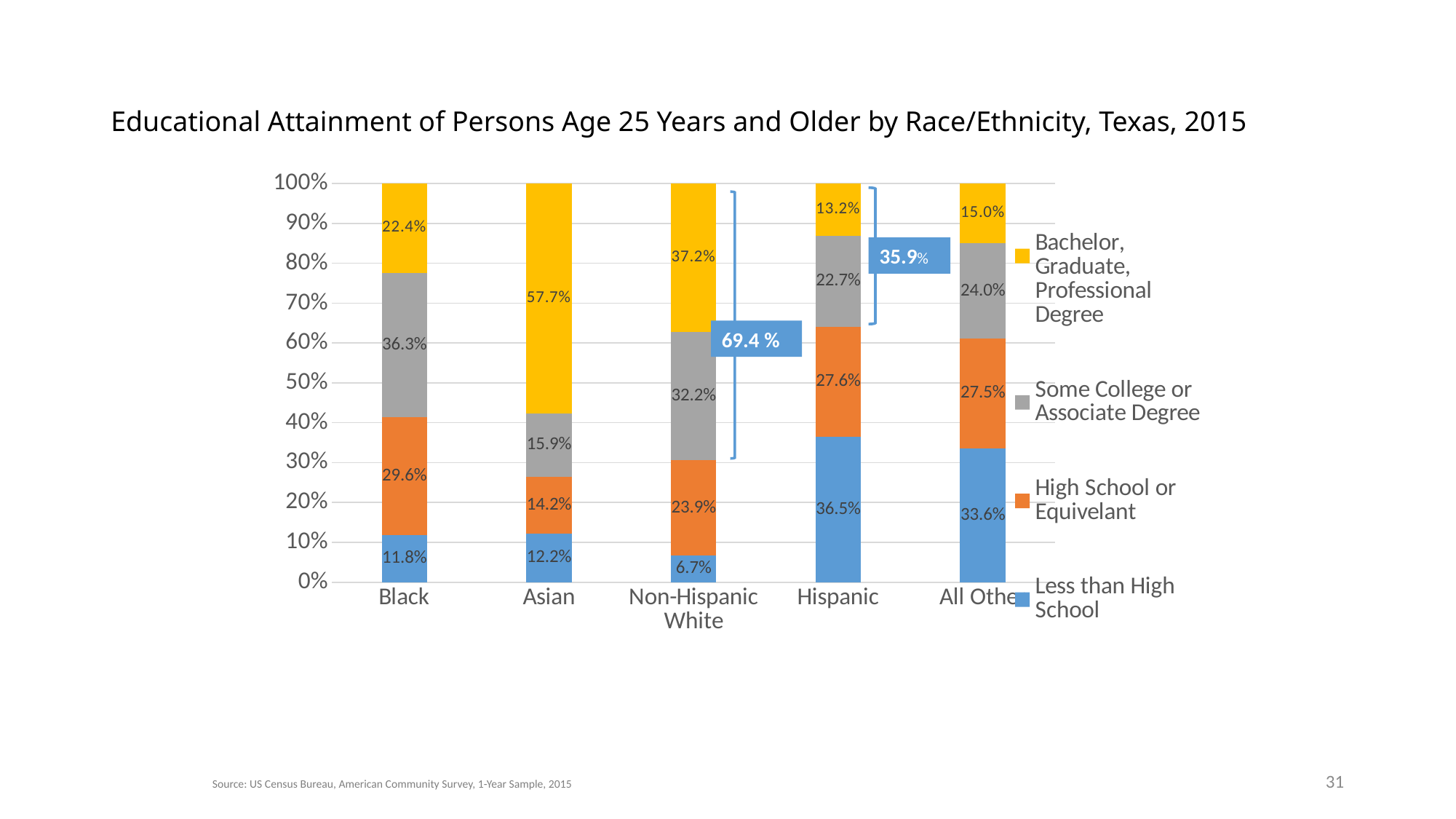
Which race/ethnicity category has the highest Bachelor, Graduate, Professional Degree share? Asian How many race/ethnicity categories are shown on the x axis? 5 What kind of chart is shown on the slide? Stacked bar chart What percentage of Asian persons age 25 and older have a Bachelor, Graduate, or Professional Degree? 57.7% What is the combined share of Some College or Associate Degree and Bachelor, Graduate, Professional Degree for Non-Hispanic White? 69.4% What is the Some College or Associate Degree value for the Black category? 36.3% How many series does the legend list? 4 What is the difference between the Bachelor, Graduate, Professional Degree shares for Asian and Hispanic? 44.5% Which race/ethnicity category has the lowest Less than High School share? Non-Hispanic White Which is larger: the Less than High School share for Hispanic or for All Other? Hispanic What is the Less than High School share for Hispanic persons? 36.5% What is the High School or Equivelant value for Non-Hispanic White? 23.9%